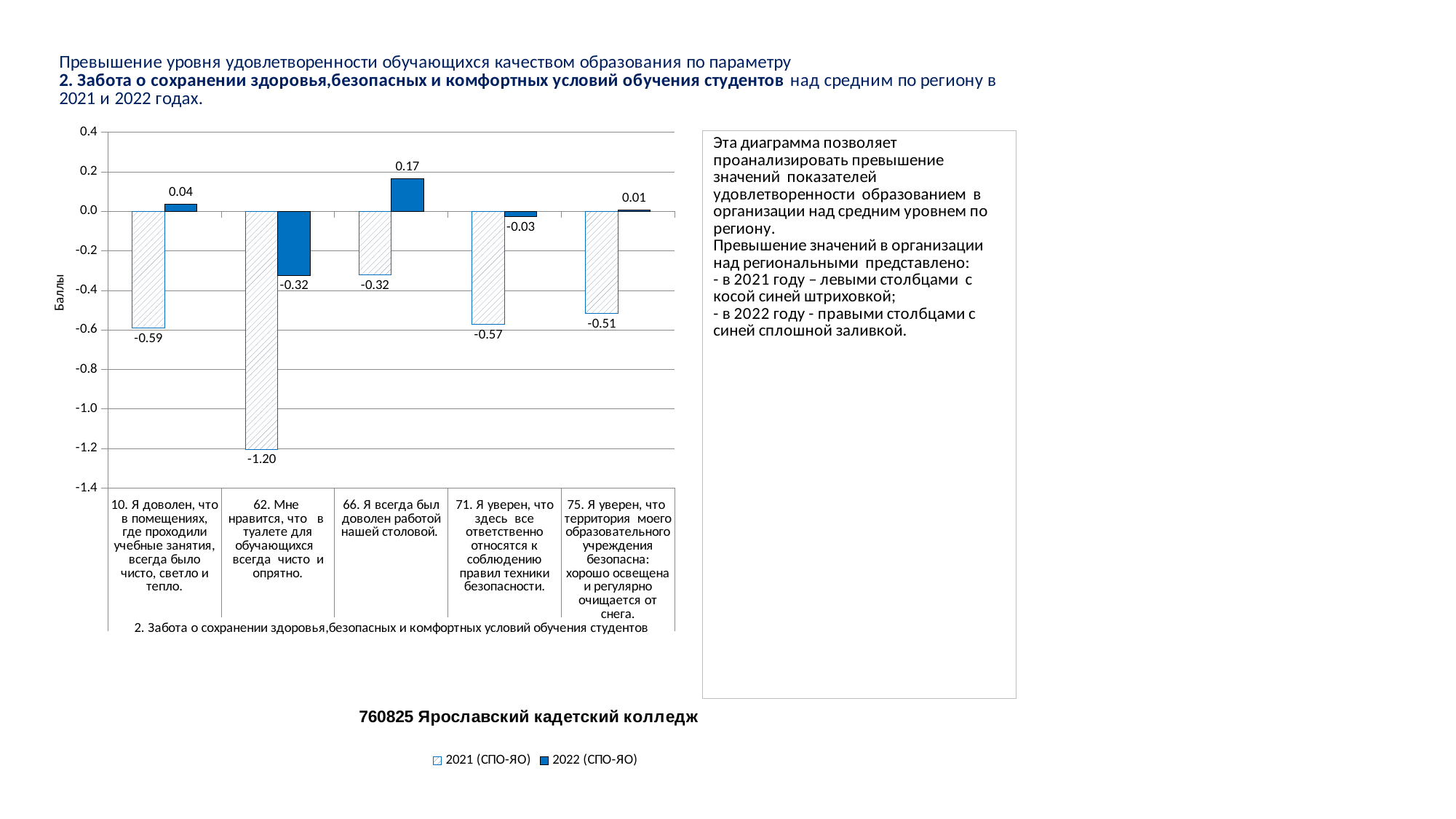
Which category has the highest 2022 (СПО-ЯО) value? 66. Я всегда был доволен работой нашей столовой. How many categories are shown on the x axis of the chart? 5 Which category has the lowest 2021 (СПО-ЯО) value? 62. Мне нравится, что в туалете для обучающихся всегда чисто и опрятно. What kind of chart is shown on the slide? Bar chart What is the 2022 (СПО-ЯО) value for category 71 (Я уверен, что здесь все ответственно относятся к соблюдению правил техники безопасности)? -0.03 Which is larger for category 75: the 2021 (СПО-ЯО) value or the 2022 (СПО-ЯО) value? 2022 (СПО-ЯО) How many series does the chart legend list? 2 What is the 2021 (СПО-ЯО) value for category 10 (Я доволен, что в помещениях, где проходили учебные занятия, всегда было чисто, светло и тепло)? -0.59 What is the 2021 (СПО-ЯО) value for category 62 (Мне нравится, что в туалете для обучающихся всегда чисто и опрятно)? -1.20 What is the 2022 (СПО-ЯО) value for category 66 (Я всегда был доволен работой нашей столовой)? 0.17 What is the difference between the 2022 and 2021 values for category 62? 0.88 What is the label of the vertical axis of the chart? Баллы